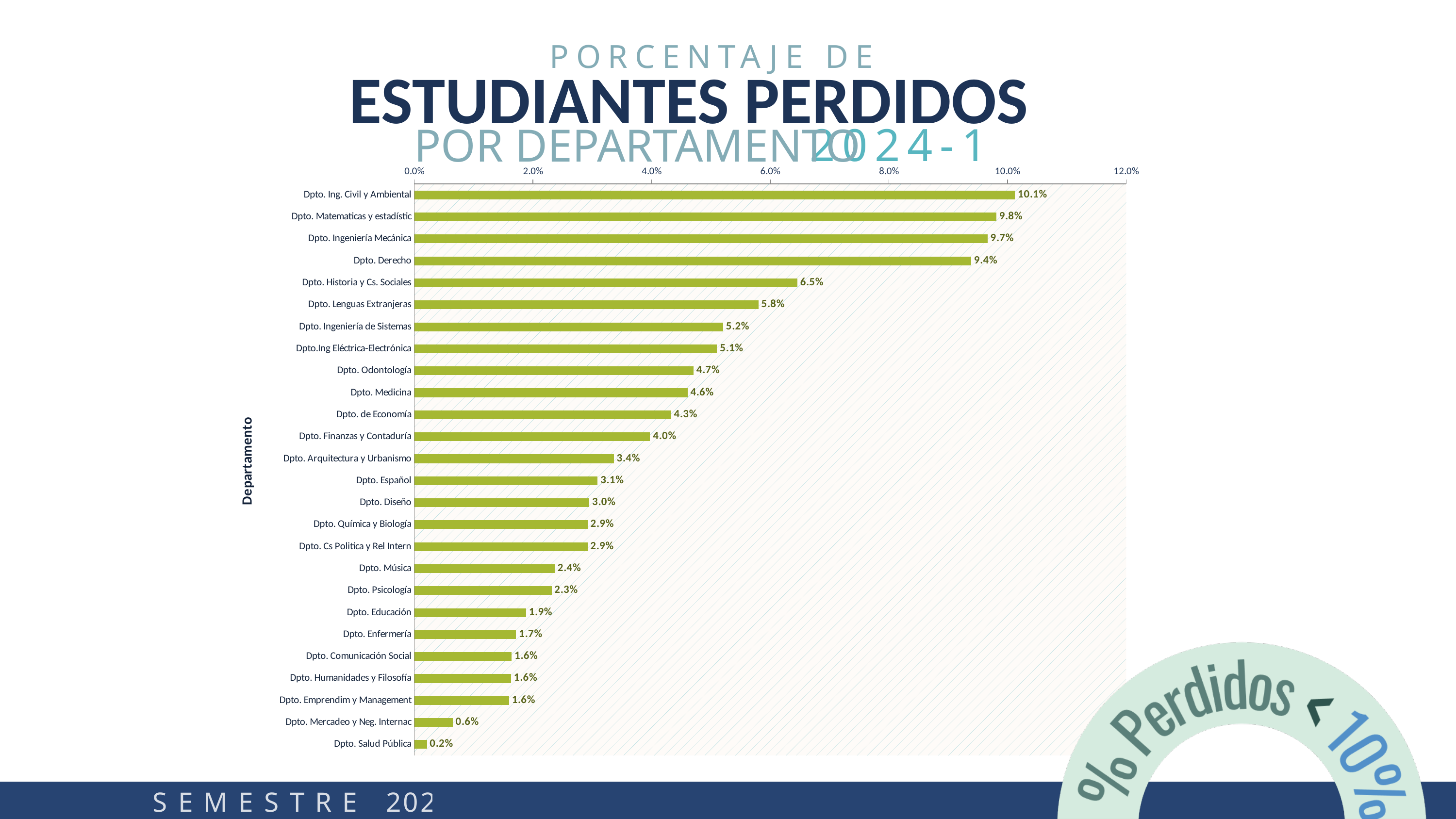
What is the difference between the values for Dpto. Historia y Cs. Sociales and Dpto. Lenguas Extranjeras? 0.7% What is the value for Dpto. Derecho? 9.4% Which department has the highest percentage of lost students? Dpto. Ing. Civil y Ambiental Is the value for Dpto. Ingeniería Mecánica greater or less than 8.0%? greater How many departments are shown in the chart? 26 What is the value for Dpto. Música? 2.4% What is the value for Dpto. Odontología? 4.7% What is the label of the vertical axis? Departamento What kind of chart is shown on the slide? bar chart What is the difference between the values for Dpto. Ing. Civil y Ambiental and Dpto. Derecho? 0.7% Which department has the lowest percentage of lost students? Dpto. Salud Pública Which is larger, the value for Dpto. Medicina or the value for Dpto. de Economía? Dpto. Medicina